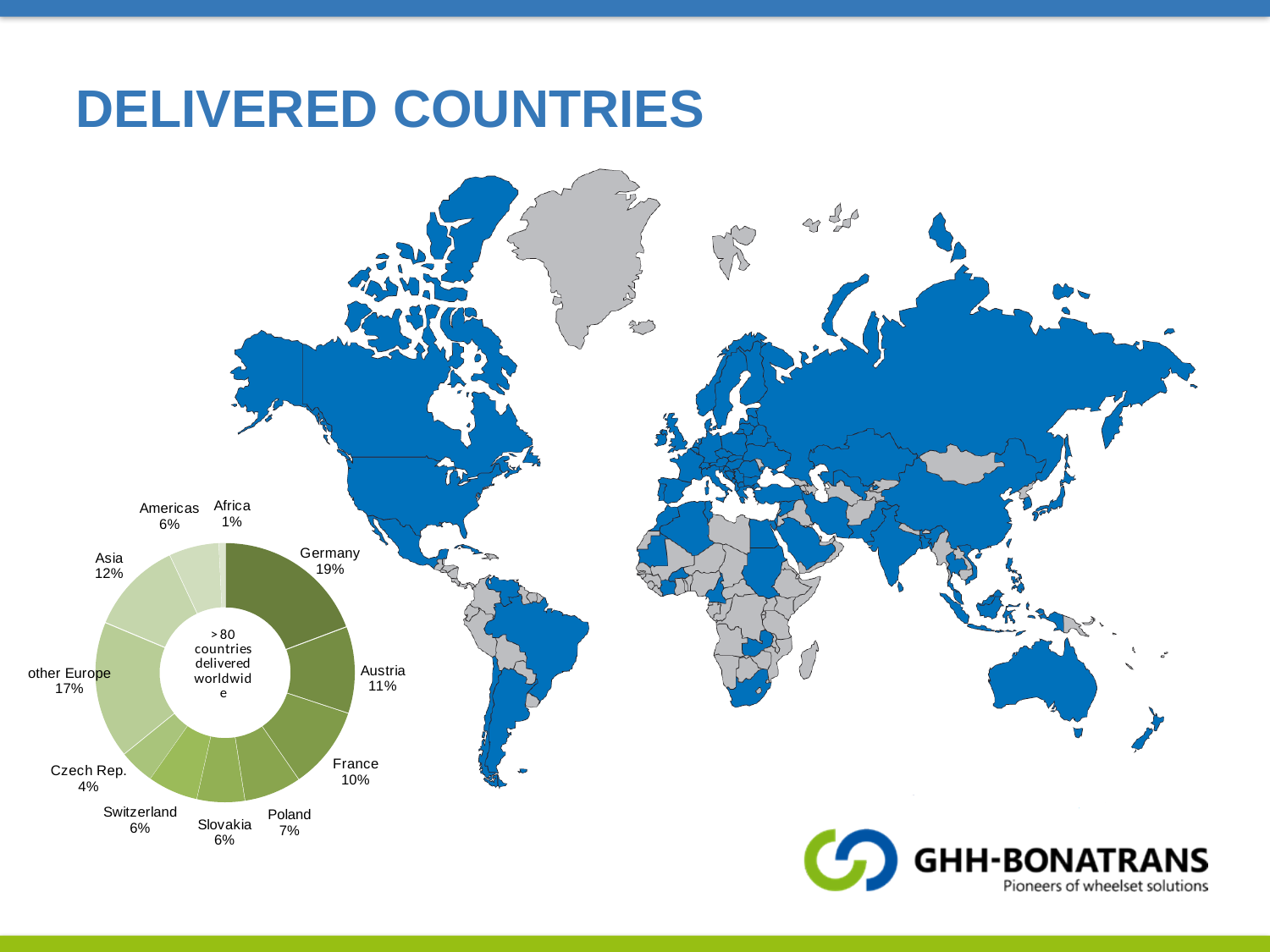
What share of the doughnut chart does Germany account for? 19% What is the difference in percentage points between Asia and Americas in the doughnut chart? 6 How many categories are shown in the doughnut chart? 11 Which category has the smallest share in the doughnut chart? Africa Which has a larger share in the doughnut chart, France or Poland? France What text is written in the centre of the doughnut chart? >80 countries delivered worldwide What is the title of the slide containing the doughnut chart? DELIVERED COUNTRIES What is the difference in percentage points between Germany and Austria in the doughnut chart? 8 What kind of chart is shown on the slide? Doughnut chart What percentage is shown for other Europe in the doughnut chart? 17% Which category has the largest share in the doughnut chart? Germany What percentage is shown for Asia in the doughnut chart? 12%